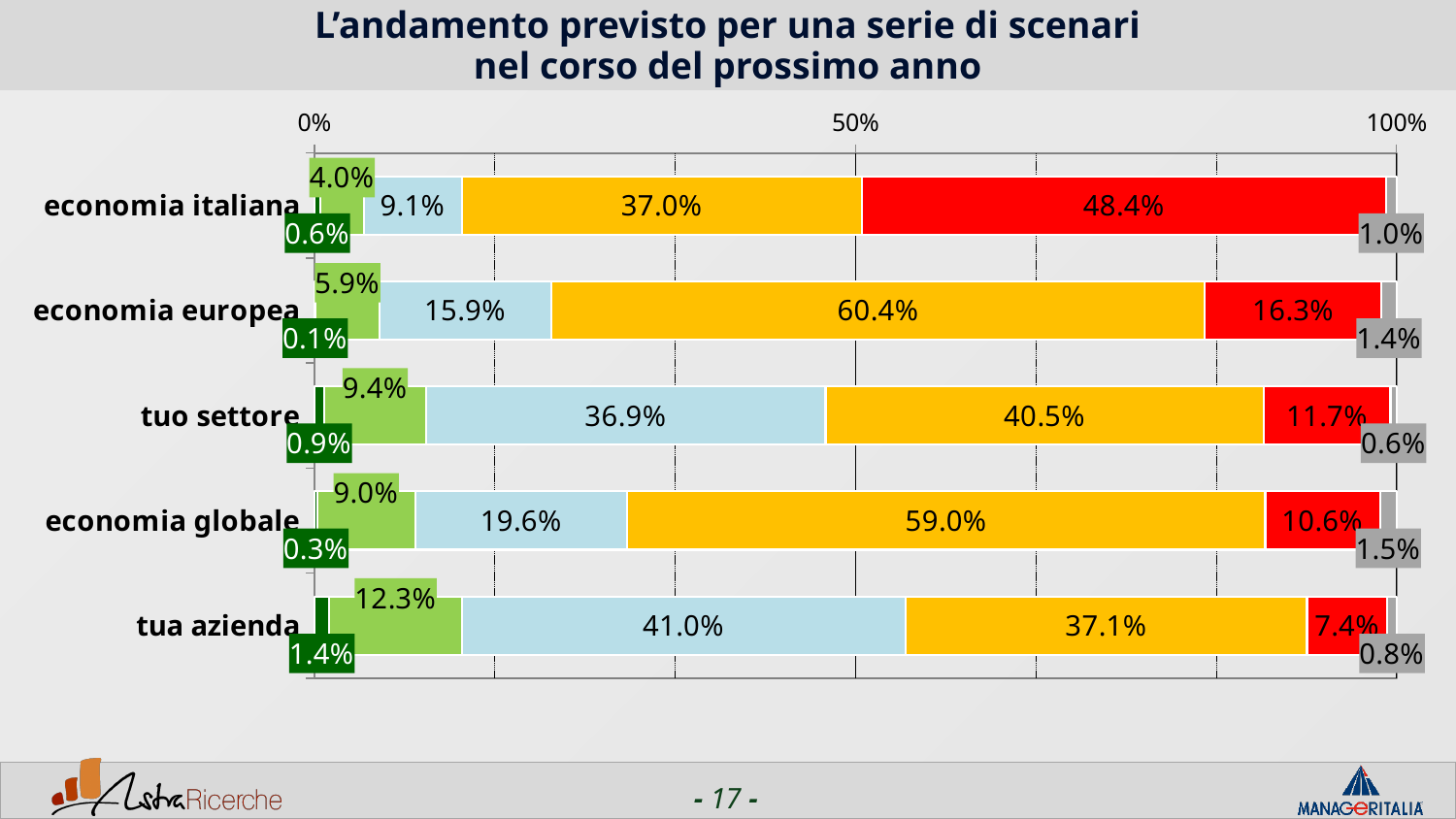
What is the value of the yellow segment for 'economia europea'? 60.4% Which is larger: the light blue segment for 'tuo settore' or the light blue segment for 'economia globale'? tuo settore Which category has the largest light blue segment? tua azienda What is the value of the light green segment for 'tua azienda'? 12.3% Which category has the smallest dark green segment? economia europea Which category has the largest red segment? economia italiana What is the difference between the yellow segment for 'economia globale' and the yellow segment for 'tua azienda'? 21.9 percentage points How many categories (scenarios) are plotted on the chart? 5 What is the value of the grey segment for 'economia globale'? 1.5% What is the title of the chart on the slide? L'andamento previsto per una serie di scenari nel corso del prossimo anno What is the value of the red segment for 'economia italiana'? 48.4% What kind of chart is shown on the slide? Stacked bar chart